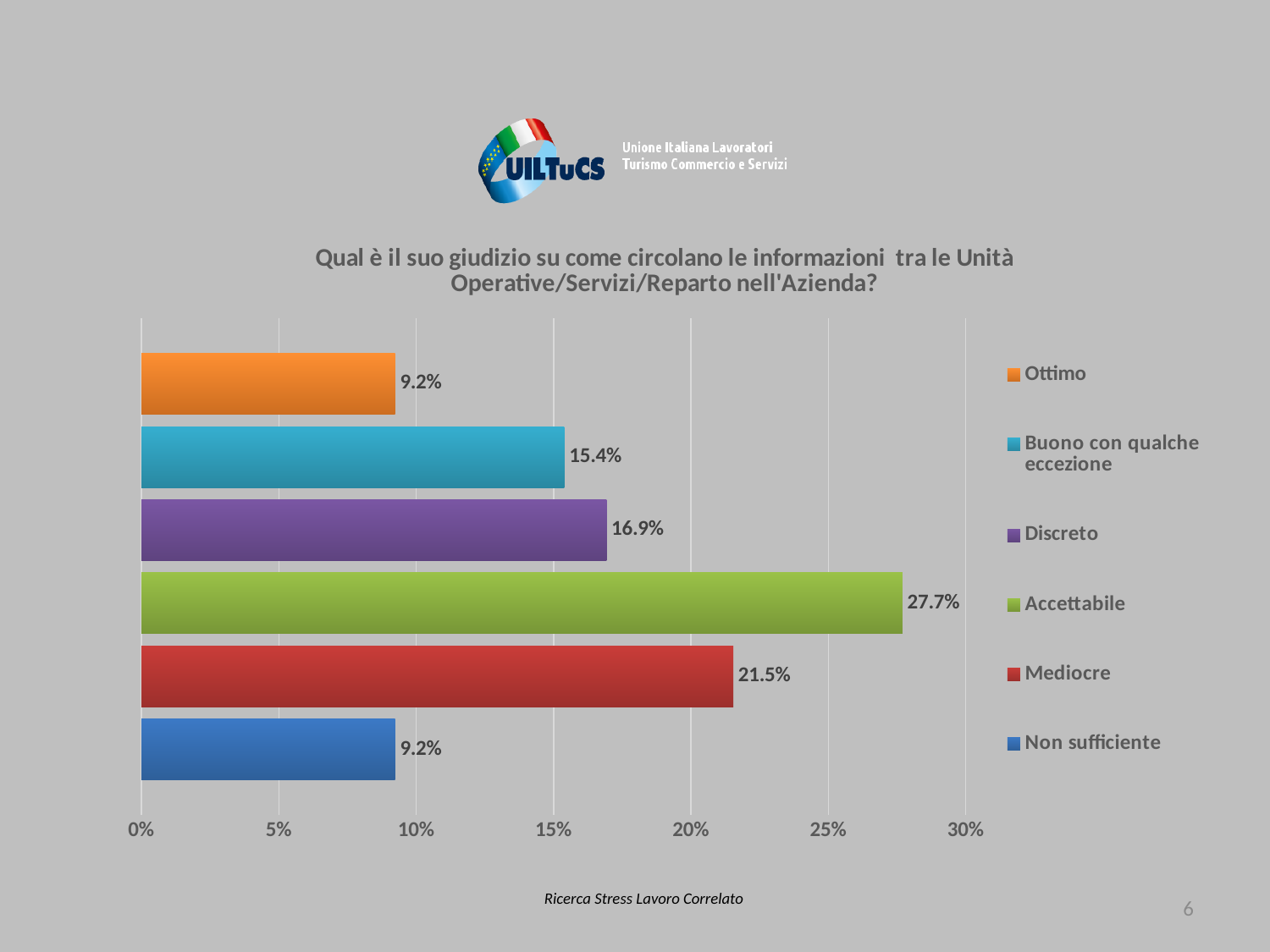
What colour is the bar for Accettabile? Green What is the value for Mediocre? 21.5% What is the value for Accettabile? 27.7% What is the value for Non sufficiente? 9.2% What is the difference between the values for Discreto and Buono con qualche eccezione? 1.5% What kind of chart is shown on the slide? Bar chart What is the value for Buono con qualche eccezione? 15.4% What is the value for Discreto? 16.9% Which is larger, the value for Mediocre or the value for Discreto? Mediocre What is the difference between the values for Accettabile and Mediocre? 6.2% How many series does the legend list? 6 Which category has the highest value? Accettabile